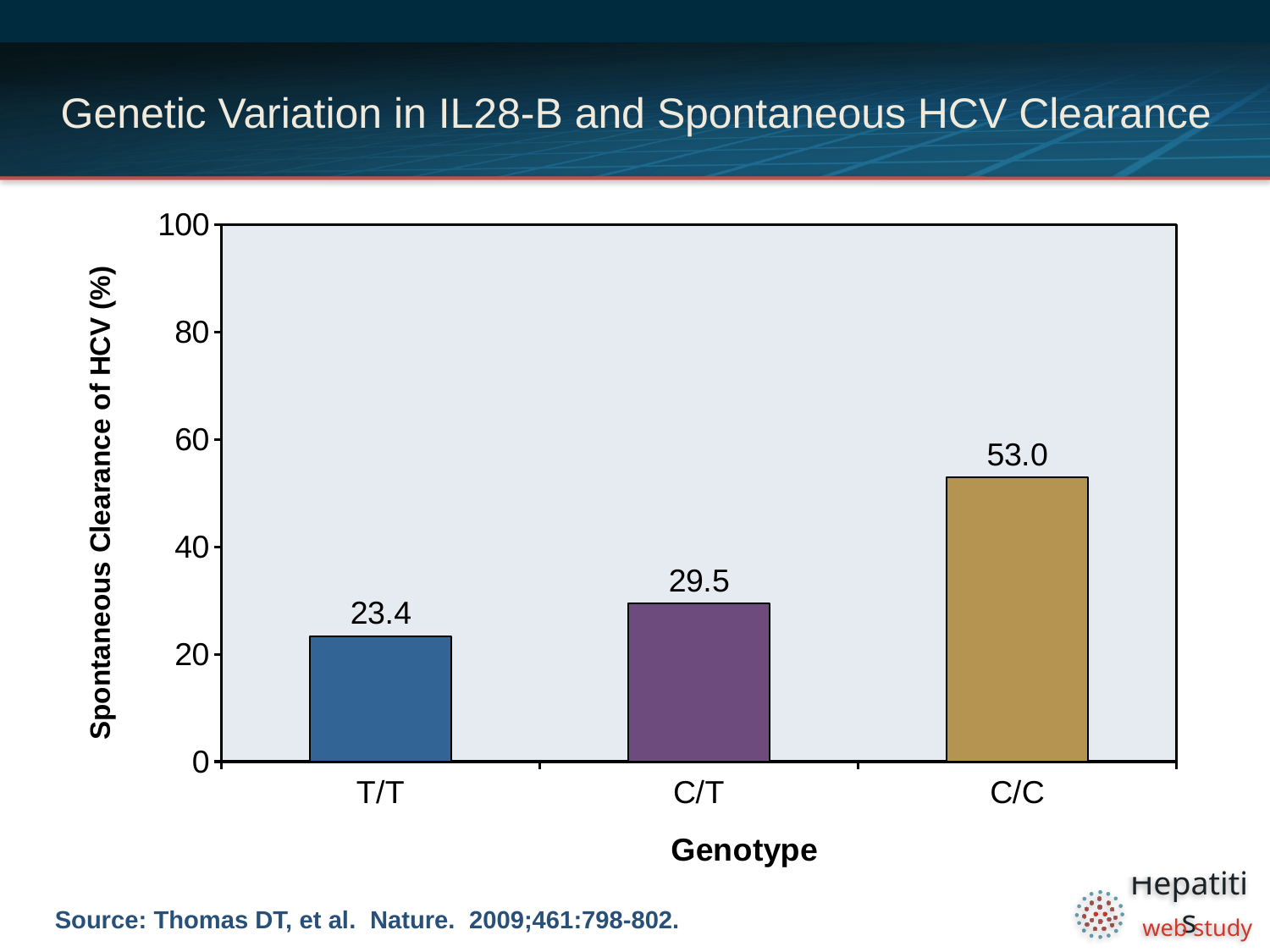
What is the spontaneous clearance of HCV (%) for the C/T genotype? 29.5 Which genotype has the highest spontaneous clearance of HCV? C/C What is the label of the x axis? Genotype What is the spontaneous clearance of HCV (%) for the C/C genotype? 53.0 What kind of chart is shown on the slide? Bar chart What is the difference in spontaneous clearance of HCV between the C/T and T/T genotypes? 6.1 What is the difference in spontaneous clearance of HCV between the C/C and T/T genotypes? 29.6 What is the spontaneous clearance of HCV (%) for the T/T genotype? 23.4 Which genotype has the lowest spontaneous clearance of HCV? T/T Is the value for the C/C genotype greater or less than 40? greater Which genotype has a higher spontaneous clearance of HCV, C/T or C/C? C/C How many genotypes are shown on the x axis? 3